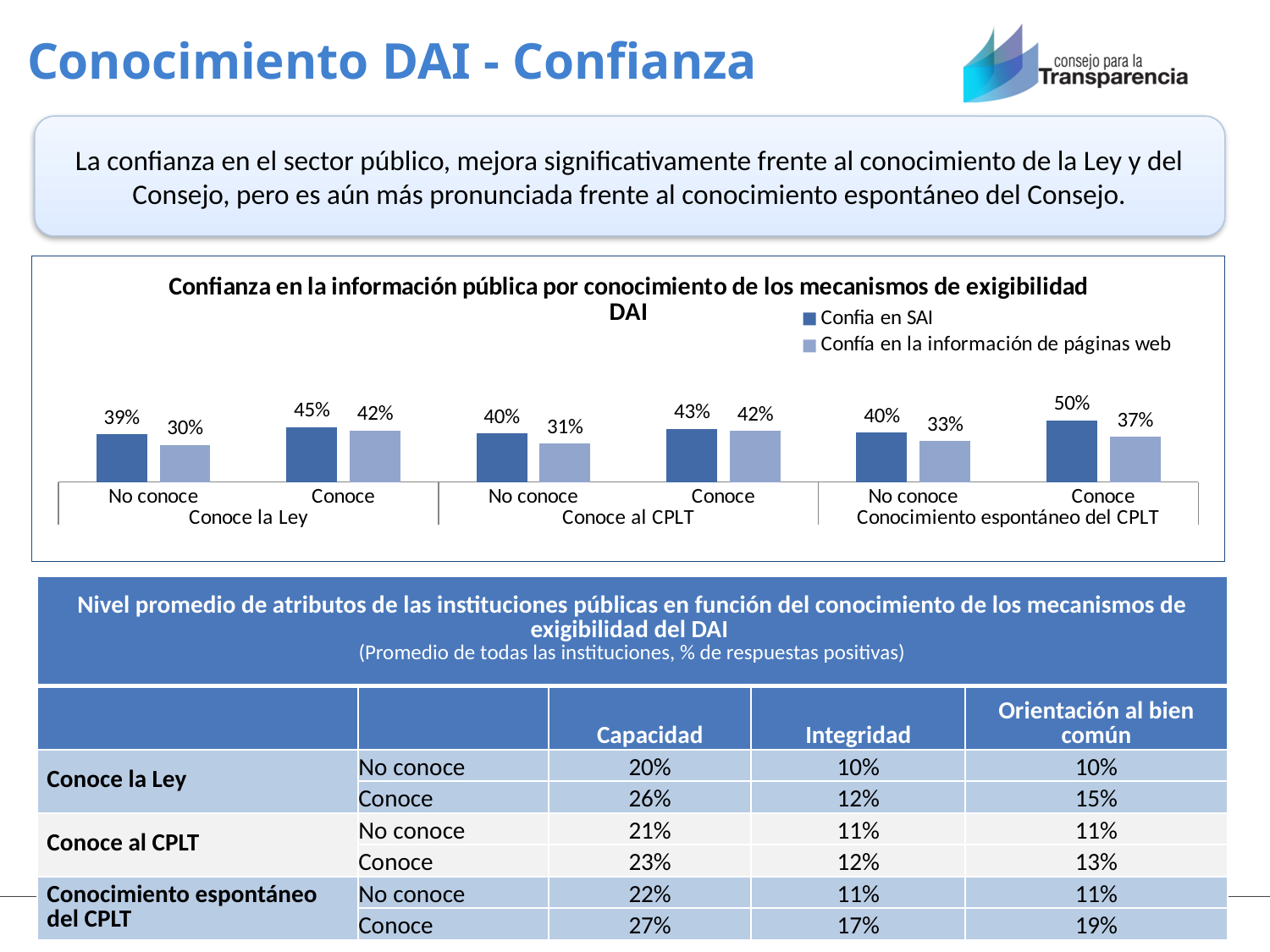
How many series does the chart legend list? 2 What type of chart is shown on the slide? bar chart What is the title of the chart? Confianza en la información pública por conocimiento de los mecanismos de exigibilidad DAI Which category has the lowest value for 'Confía en la información de páginas web'? No conoce (Conoce la Ley) Which category has the highest value for 'Confia en SAI'? Conoce (Conocimiento espontáneo del CPLT) What is the value of 'Confia en SAI' for 'No conoce' under 'Conoce al CPLT'? 40% What is the difference between 'Confía en la información de páginas web' for 'Conoce' and 'No conoce' under 'Conoce la Ley'? 12% What is the difference between 'Confia en SAI' for 'Conoce' and 'No conoce' under 'Conocimiento espontáneo del CPLT'? 10% What is the value of 'Confia en SAI' for 'Conoce' under 'Conocimiento espontáneo del CPLT'? 50% How many category groups (No conoce / Conoce pairs) are shown on the x axis of the chart? 3 Under 'Conoce al CPLT', which is larger for 'Conoce': 'Confia en SAI' or 'Confía en la información de páginas web'? Confia en SAI What is the value of 'Confía en la información de páginas web' for 'No conoce' under 'Conoce la Ley'? 30%